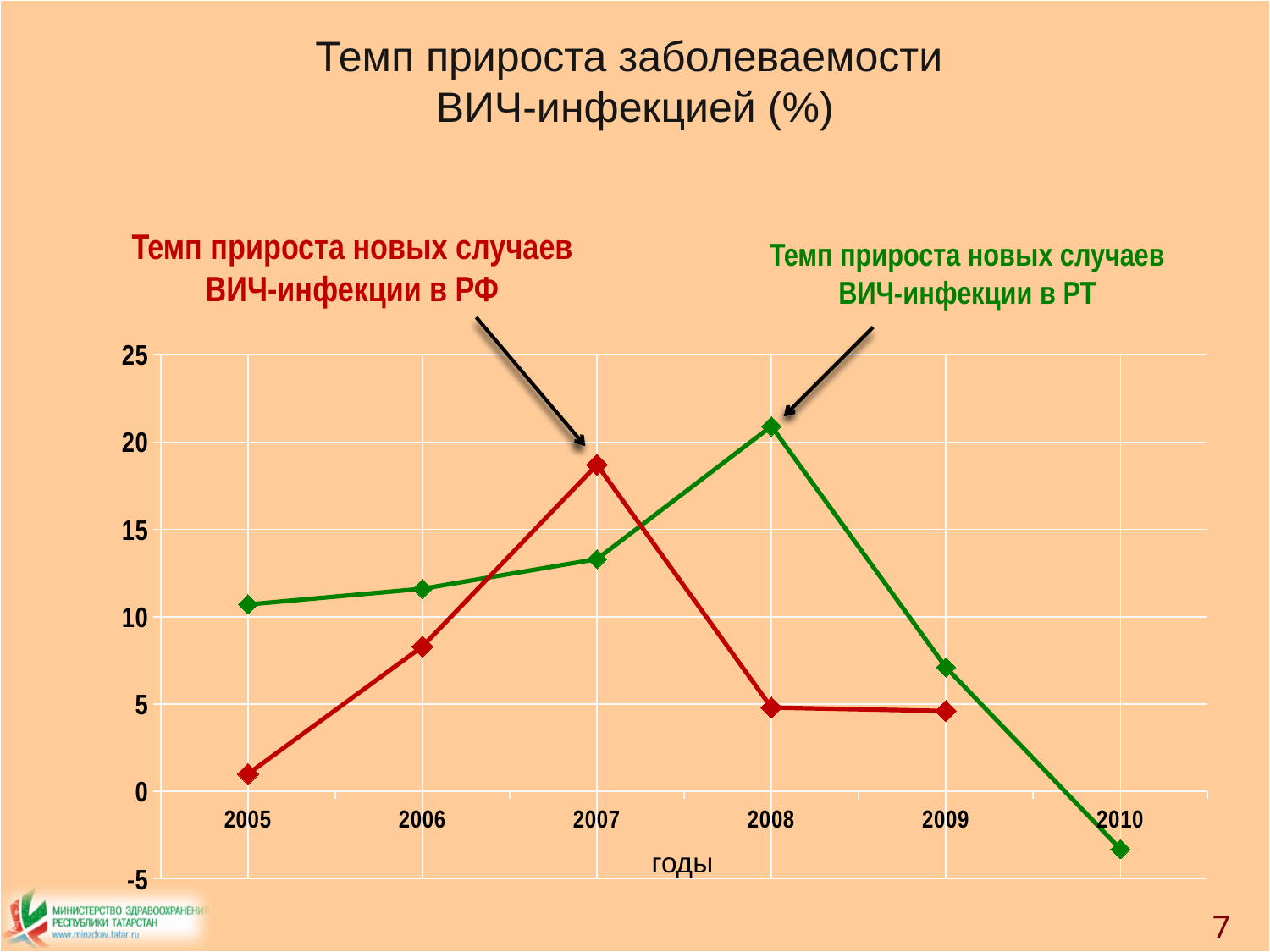
Is the value of the red line (РФ) in 2007 greater or less than 15? greater In which year is the red line (РФ) at its lowest value? 2005 Does the green line (РТ) rise or fall from 2008 to 2010? fall In which year does the green line (Темп прироста новых случаев ВИЧ-инфекции в РТ) reach its highest value? 2008 In which year is the green line (РТ) at its lowest value? 2010 How many data series are plotted on the chart? 2 Is the value of the green line (РТ) in 2010 greater or less than 0? less In 2008, which series has the higher value: the red line (РФ) or the green line (РТ)? the green line (РТ) What kind of chart is shown on the slide? line chart In which year does the red line (Темп прироста новых случаев ВИЧ-инфекции в РФ) reach its highest value? 2007 How many years are labelled on the x axis of the chart? 6 Is the value of the red line (РФ) in 2005 greater or less than 5? less